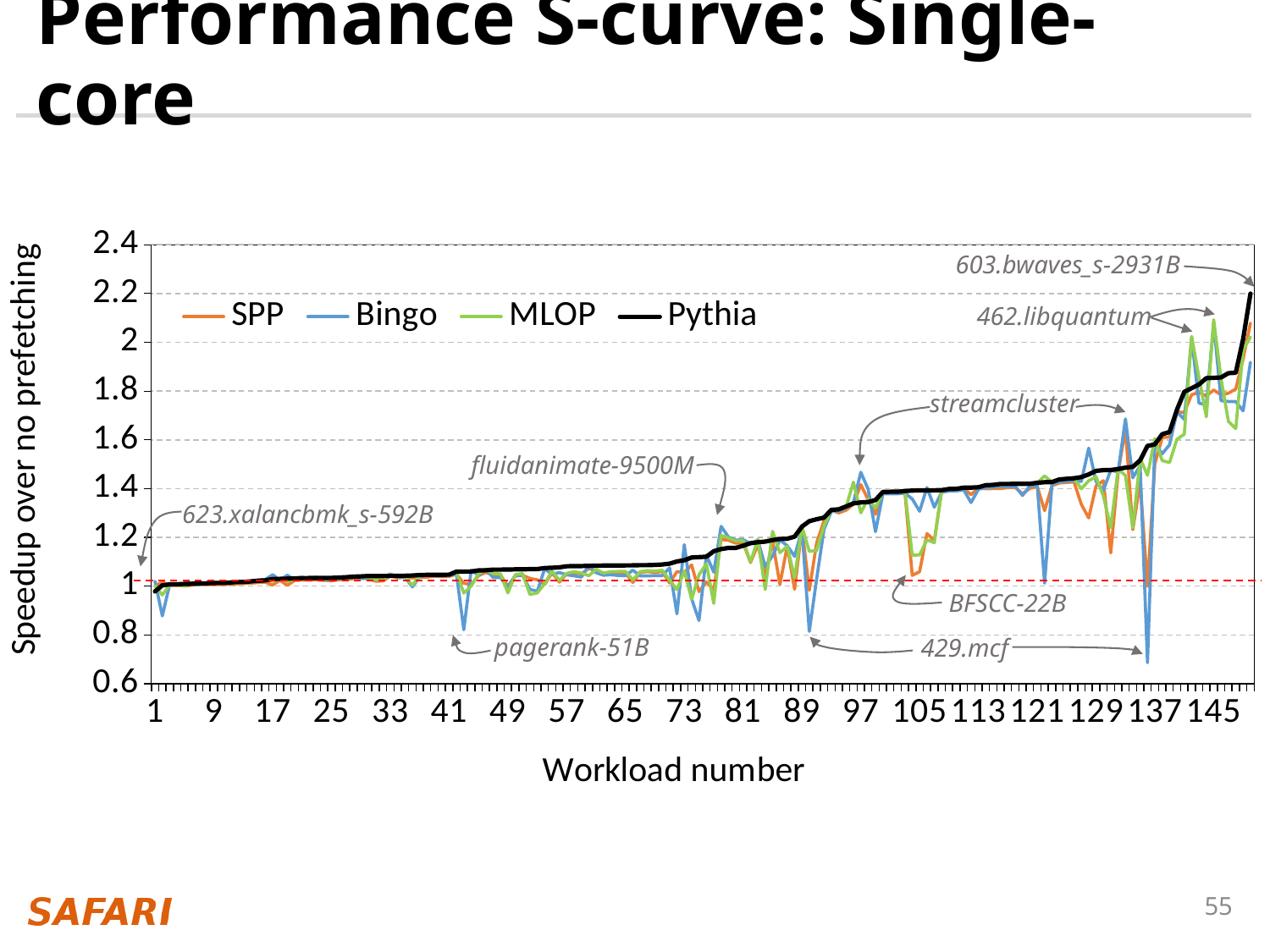
What kind of chart is shown on the slide? Line chart Is the lowest value of Bingo near workload 137 greater or less than 0.8? less Is the value of Pythia at workload 97 greater or less than 1.2? greater Is the value of Pythia at workload 1 greater or less than 1.2? less Does the Pythia line rise or fall as the workload number increases? Rises Which series dips to the lowest value anywhere on the chart? Bingo How many series does the legend list? 4 Which series are listed in the legend? SPP, Bingo, MLOP, Pythia At the rightmost workload, which is larger, the Pythia value or the Bingo value? Pythia Which series reaches the highest value at the rightmost workload? Pythia What is the label of the y axis? Speedup over no prefetching